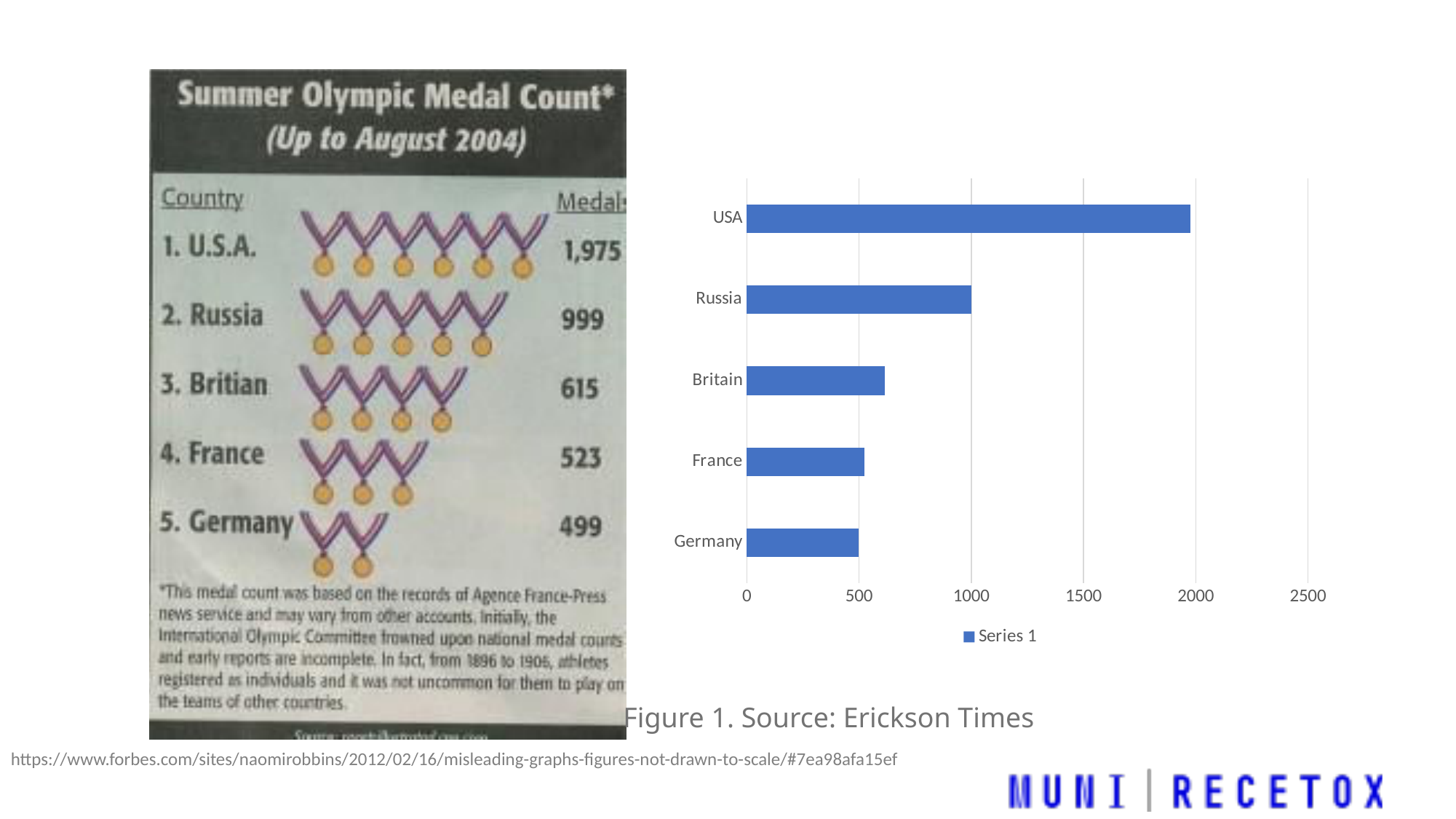
In the Summer Olympic Medal Count clipping on the left, how many medals are listed for France? 523 In the bar chart on the right, is the value for Germany greater or less than 1000? less How many countries are plotted in the bar chart on the right? 5 How many series does the legend of the bar chart list? 1 What kind of chart is shown on the right side of the slide? bar chart In the Summer Olympic Medal Count clipping on the left, which country has the lowest medal count? Germany In the bar chart on the right, which bar is longer, Britain or France? Britain What is the legend entry of the bar chart on the right? Series 1 In the bar chart on the right, which country has the longest bar? USA In the bar chart on the right, is the value for Britain greater or less than 500? greater In the Summer Olympic Medal Count clipping on the left, how many medals are listed for Russia? 999 In the bar chart on the right, is the value for USA greater or less than 1500? greater